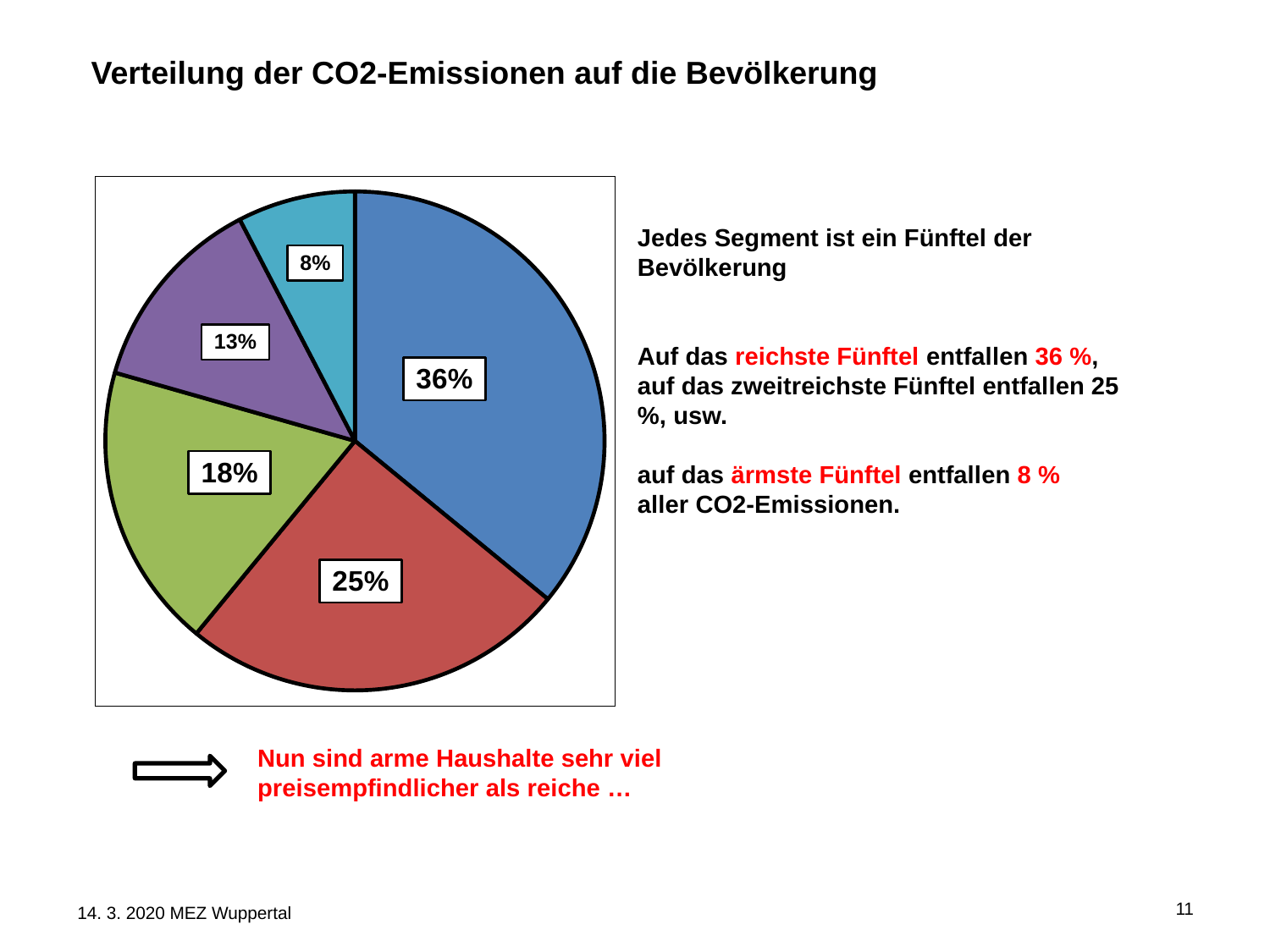
What percentage is shown on the smallest slice of the pie chart? 8% What value is printed on the blue slice of the pie chart? 36% What percentage is shown on the largest slice of the pie chart? 36% What value is printed on the green slice of the pie chart? 18% How many slices does the pie chart have? 5 What value is printed on the purple slice of the pie chart? 13% Which slice is larger, the red slice or the green slice? the red slice (25%) What is the title of the slide containing the pie chart? Verteilung der CO2-Emissionen auf die Bevölkerung What is the difference between the largest slice (36%) and the smallest slice (8%) of the pie chart? 28% According to the slide, what share of CO2 emissions falls on the richest fifth of the population? 36% What kind of chart is shown on the slide? pie chart What value is printed on the red slice of the pie chart? 25%